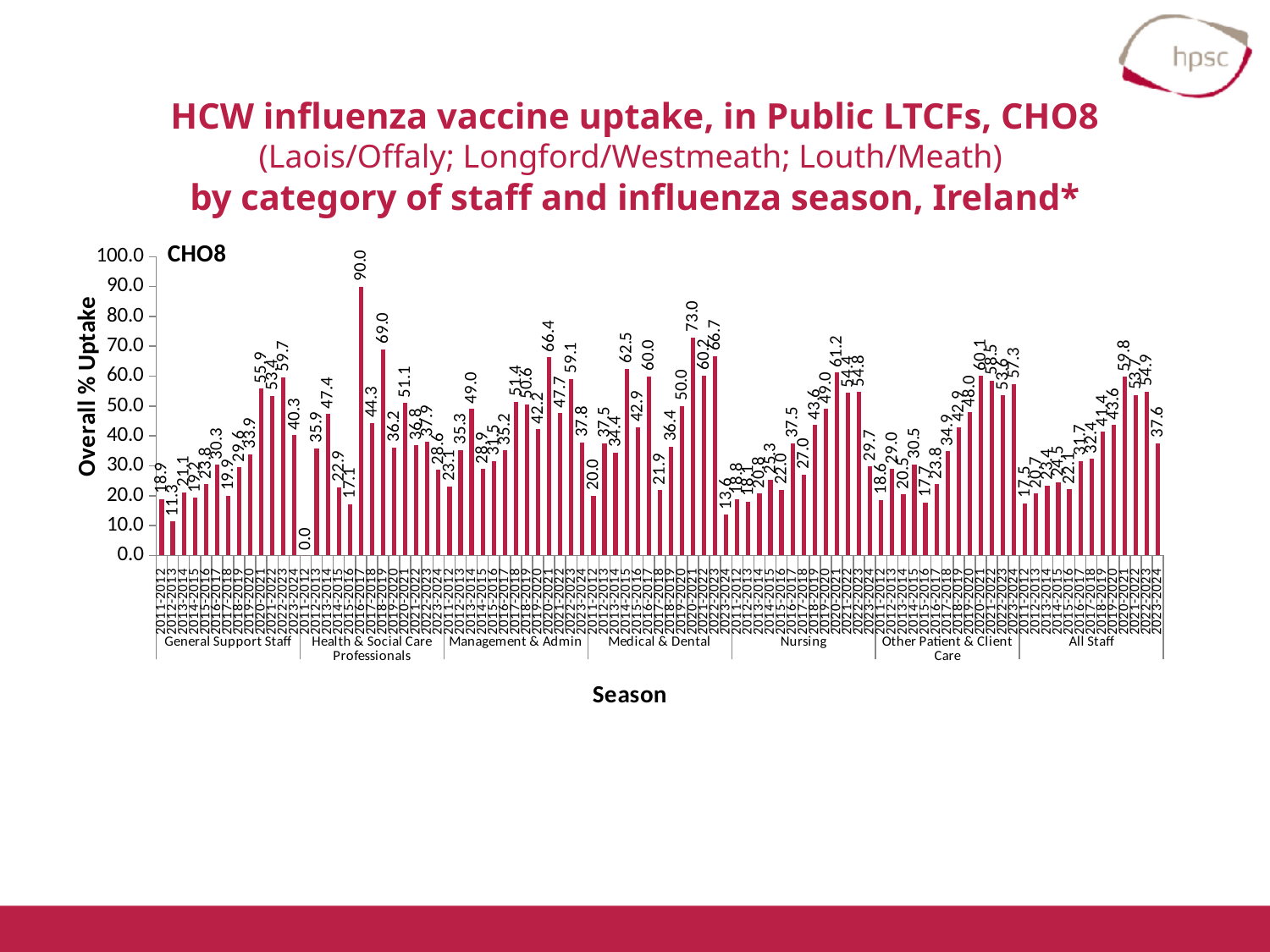
What is the label on the y axis of the chart? Overall % Uptake What type of chart is shown on the slide? Bar chart What is the difference between the Medical & Dental uptake in 2020-2021 (73.0) and in 2019-2020 (50.0)? 23.0 Which is larger: the Health & Social Care Professionals uptake in 2018-2019 or the Management & Admin uptake in 2019-2020? Health & Social Care Professionals 2018-2019 (69.0) How many staff categories are shown along the x axis of the chart? 7 What is the uptake value for All Staff in the 2023-2024 season? 37.6 What is the uptake value for General Support Staff in the 2011-2012 season? 18.9 Which staff category and season has the lowest uptake value in the chart? Health & Social Care Professionals, 2011-2012 (0.0) What is the uptake value for Medical & Dental staff in the 2020-2021 season? 73.0 Is the uptake value for All Staff in 2020-2021 greater or less than 50.0? greater Which staff category and season has the highest uptake value in the chart? Health & Social Care Professionals, 2016-2017 (90.0) What is the uptake value for Nursing in the 2020-2021 season? 61.2